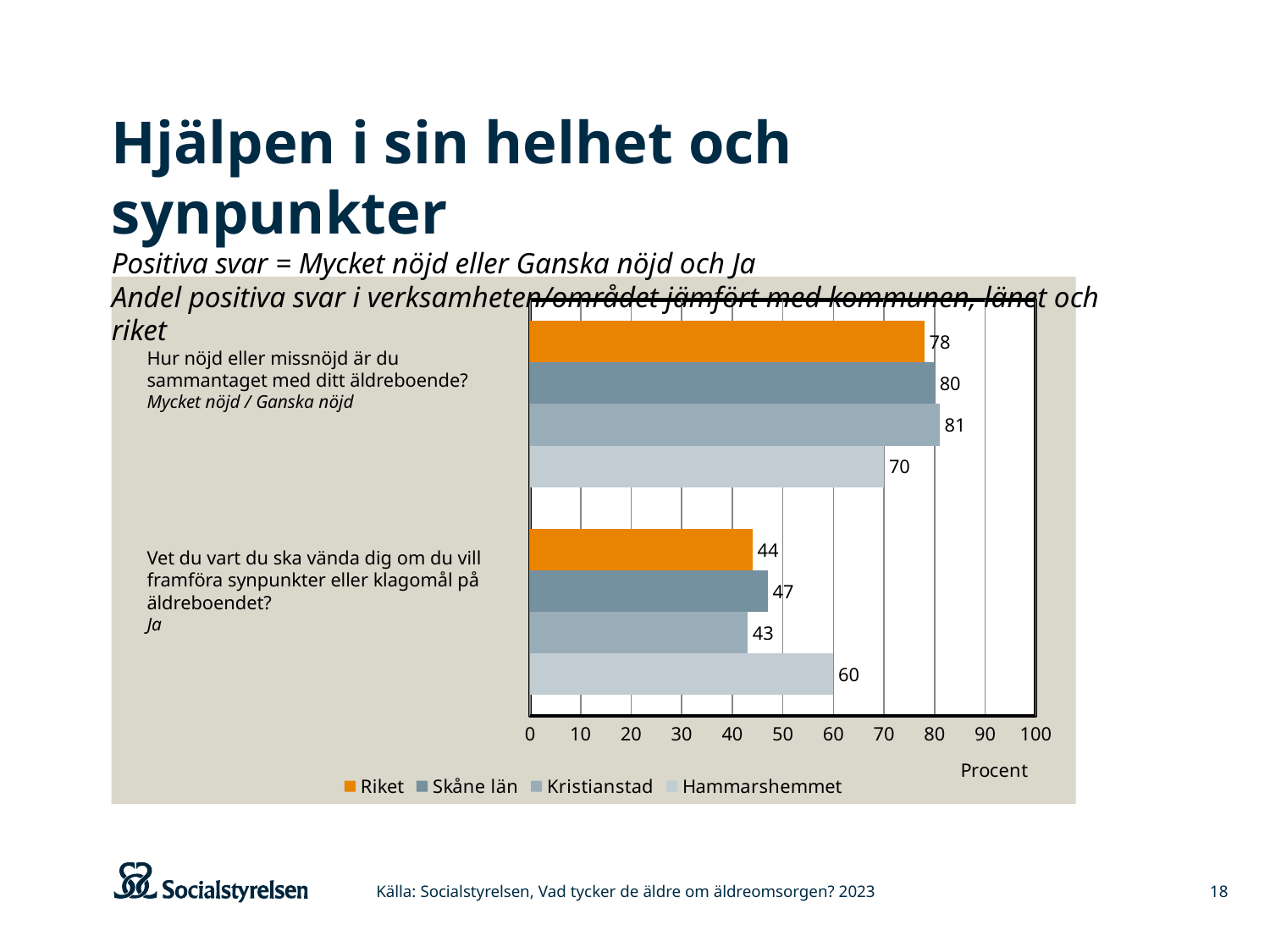
How many series does the legend list? 4 Which is larger on the question about overall satisfaction: Skåne län or Hammarshemmet? Skåne län What is the value for Riket on the question about how satisfied you are overall with your elderly housing (Hur nöjd eller missnöjd är du sammantaget med ditt äldreboende)? 78 Which series is shown in orange in the legend? Riket What is the value for Hammarshemmet on the question about whether you know where to turn to give feedback or complaints (Vet du vart du ska vända dig...)? 60 What is the difference between Hammarshemmet and Riket on the question about knowing where to turn with feedback or complaints? 16 What is the label on the x axis of the chart? Procent What is the value for Kristianstad on the question about overall satisfaction with the elderly housing? 81 What kind of chart is shown on the slide? bar chart Which series has the lowest value on the question about knowing where to turn with feedback or complaints? Kristianstad Which series has the highest value on the question about overall satisfaction with the elderly housing? Kristianstad Is the value for Skåne län on the question about knowing where to turn with feedback or complaints greater or less than 50? less